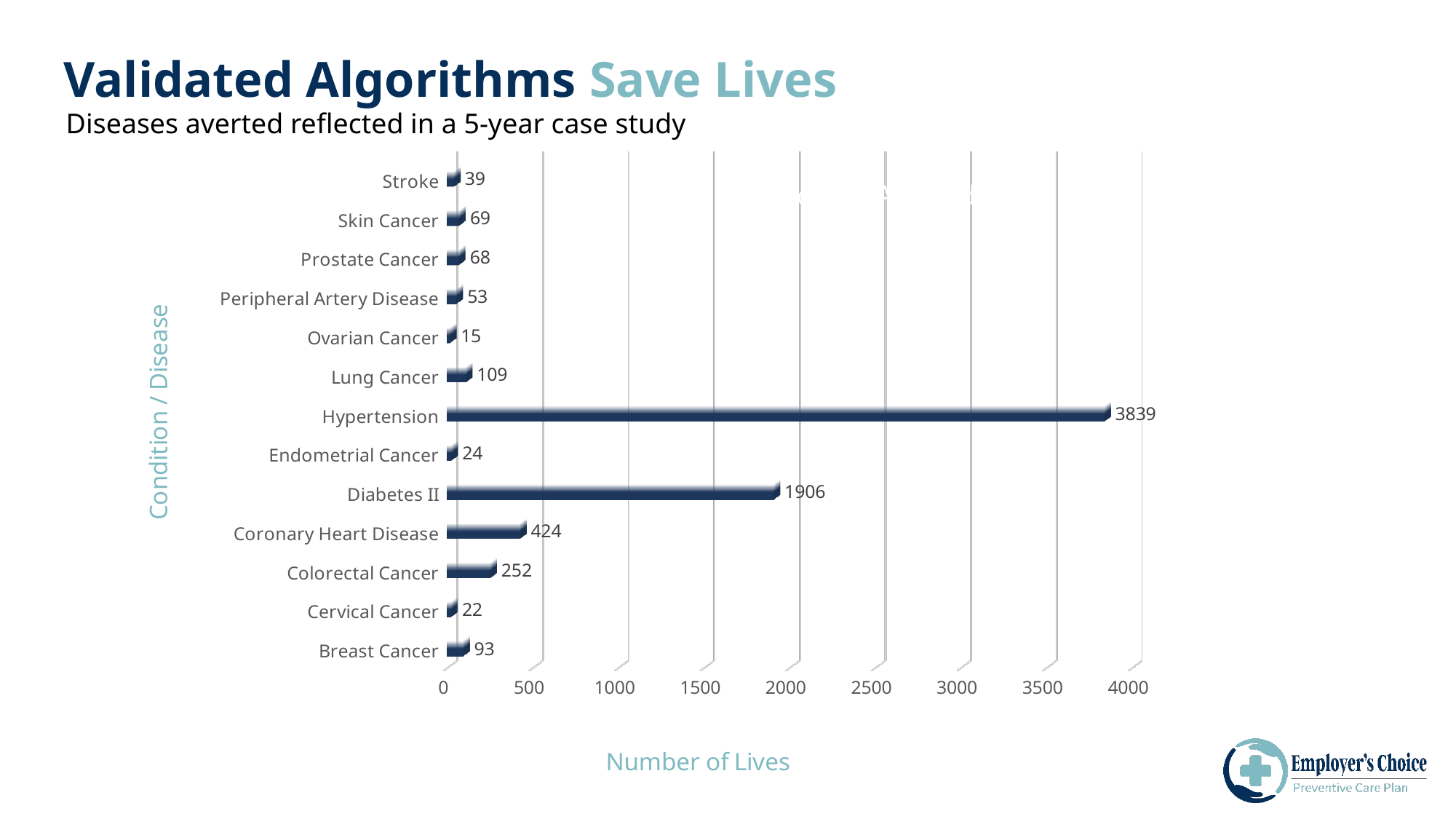
Which condition has the lowest number of lives? Ovarian Cancer What is the number of lives for Hypertension? 3839 What is the number of lives for Diabetes II? 1906 What kind of chart is shown on the slide? Bar chart What is the label of the horizontal axis? Number of Lives Which condition has the highest number of lives? Hypertension How many conditions are shown on the chart? 13 Is the value for Diabetes II greater or less than 1500? greater What is the number of lives for Coronary Heart Disease? 424 What is the difference between the values for Hypertension and Diabetes II? 1933 What is the number of lives for Ovarian Cancer? 15 Which is larger, the value for Colorectal Cancer or the value for Lung Cancer? Colorectal Cancer